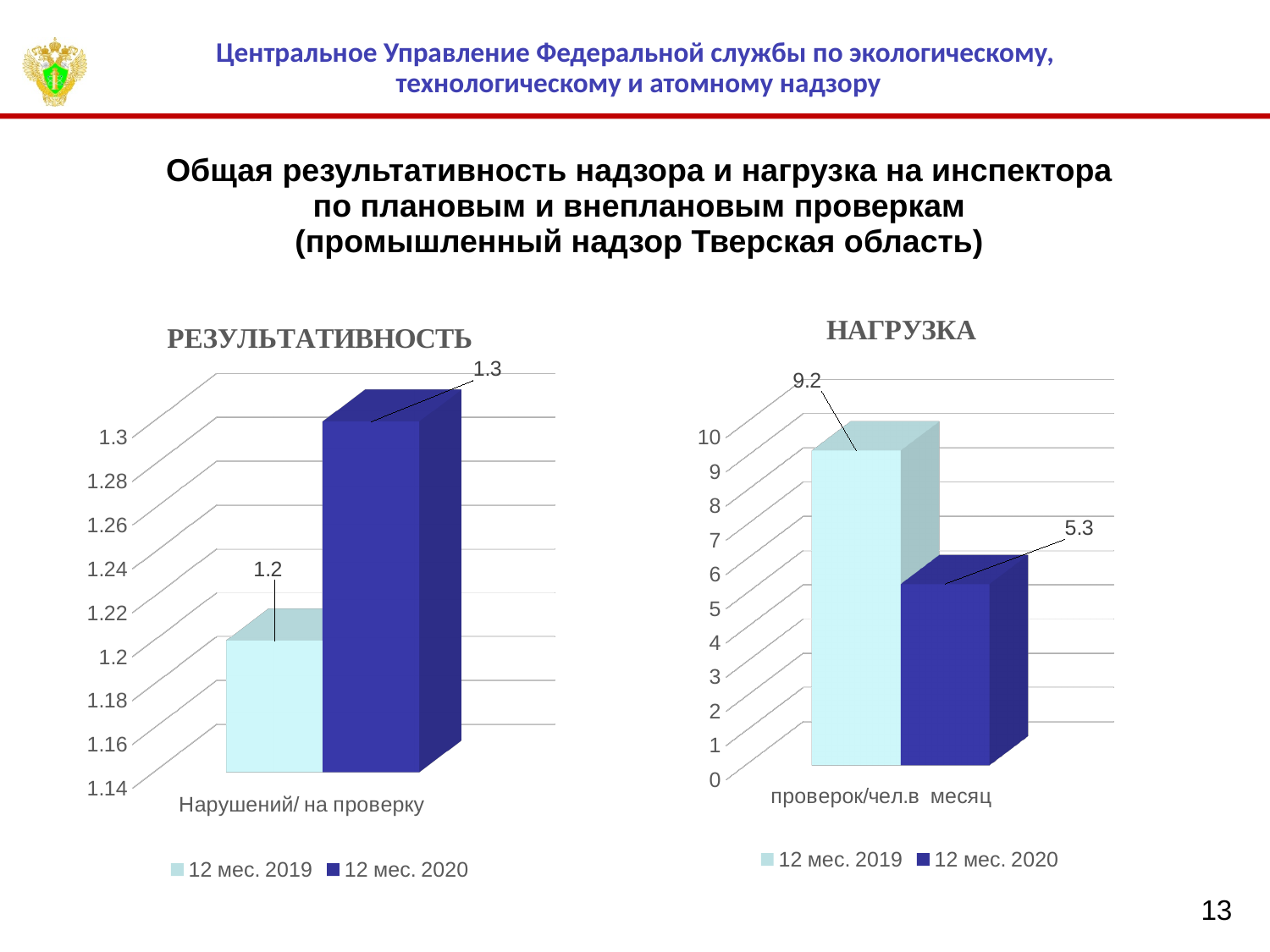
In the НАГРУЗКА chart, is the value for 12 мес. 2020 greater or less than 6? less What kind of chart is the РЕЗУЛЬТАТИВНОСТЬ chart? bar chart In the НАГРУЗКА chart, which series has the higher value? 12 мес. 2019 In the НАГРУЗКА chart, what is the value for 12 мес. 2020? 5.3 What is the category label on the x axis of the НАГРУЗКА chart? проверок/чел.в месяц In the РЕЗУЛЬТАТИВНОСТЬ chart, which series has the lower value? 12 мес. 2019 In the РЕЗУЛЬТАТИВНОСТЬ chart, what is the difference between the 12 мес. 2020 and 12 мес. 2019 values? 0.1 In the НАГРУЗКА chart, what is the value for 12 мес. 2019? 9.2 In the НАГРУЗКА chart, what is the difference between the 12 мес. 2019 and 12 мес. 2020 values? 3.9 How many series does the legend of the НАГРУЗКА chart list? 2 In the РЕЗУЛЬТАТИВНОСТЬ chart, what is the value for 12 мес. 2019? 1.2 In the РЕЗУЛЬТАТИВНОСТЬ chart, what is the value for 12 мес. 2020? 1.3